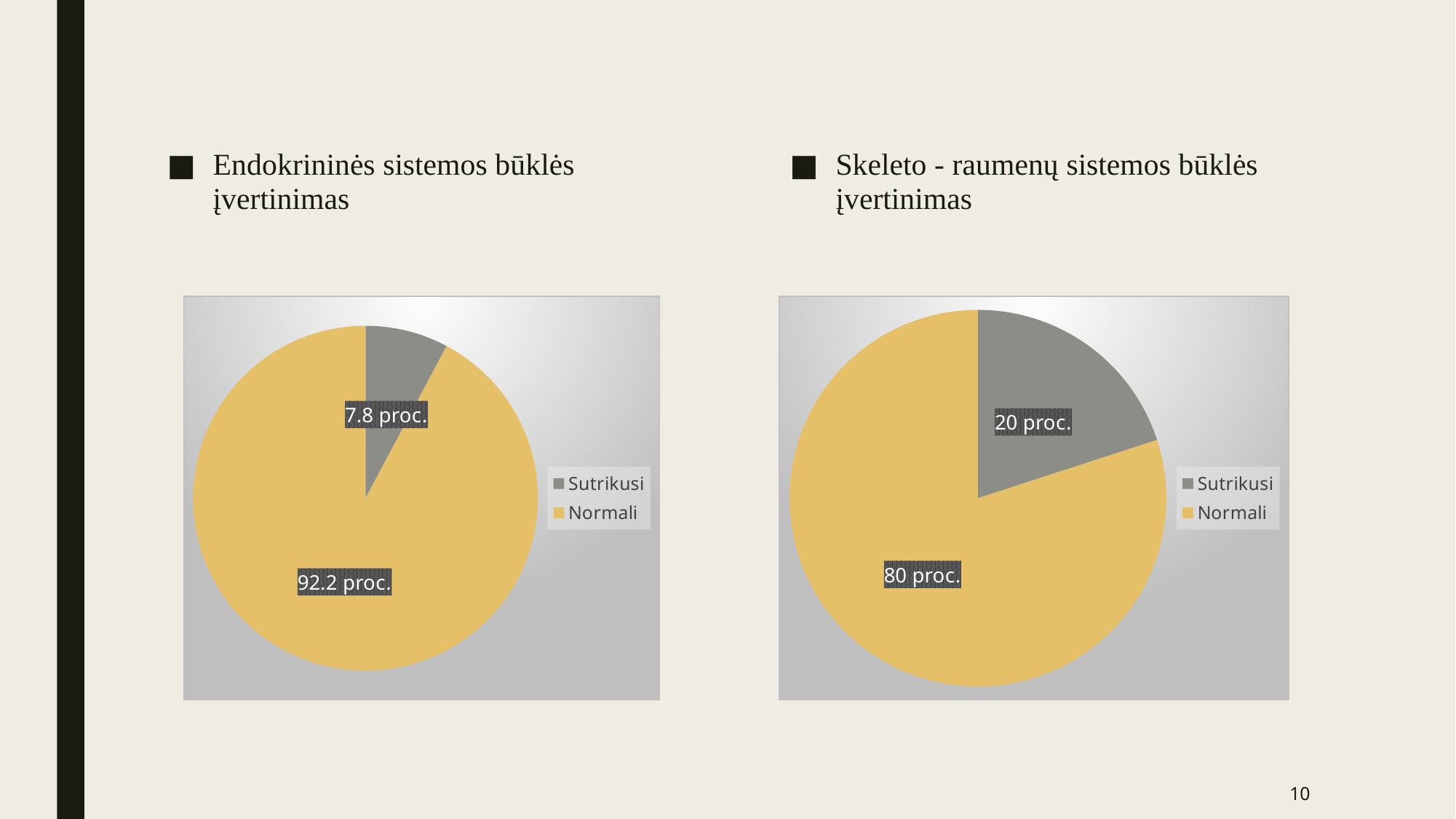
How many categories does the legend of the right chart (Skeleto - raumenų sistemos būklės įvertinimas) list? 2 What kind of chart is the left chart (Endokrininės sistemos būklės įvertinimas)? pie chart On the right chart (Skeleto - raumenų sistemos būklės įvertinimas), what is the value for Sutrikusi? 20 proc. On the right chart (Skeleto - raumenų sistemos būklės įvertinimas), what colour is the Normali slice? yellow On the right chart (Skeleto - raumenų sistemos būklės įvertinimas), what is the value for Normali? 80 proc. On the left chart (Endokrininės sistemos būklės įvertinimas), what is the difference between the Normali and Sutrikusi values? 84.4 proc. On the left chart (Endokrininės sistemos būklės įvertinimas), what is the value for Normali? 92.2 proc. Which chart has the larger Sutrikusi value, the left chart or the right chart? the right chart On the right chart (Skeleto - raumenų sistemos būklės įvertinimas), what is the difference between the Normali and Sutrikusi values? 60 proc. On the left chart (Endokrininės sistemos būklės įvertinimas), what is the value for Sutrikusi? 7.8 proc. On the left chart (Endokrininės sistemos būklės įvertinimas), which category has the largest slice? Normali On the right chart (Skeleto - raumenų sistemos būklės įvertinimas), which category has the smallest slice? Sutrikusi